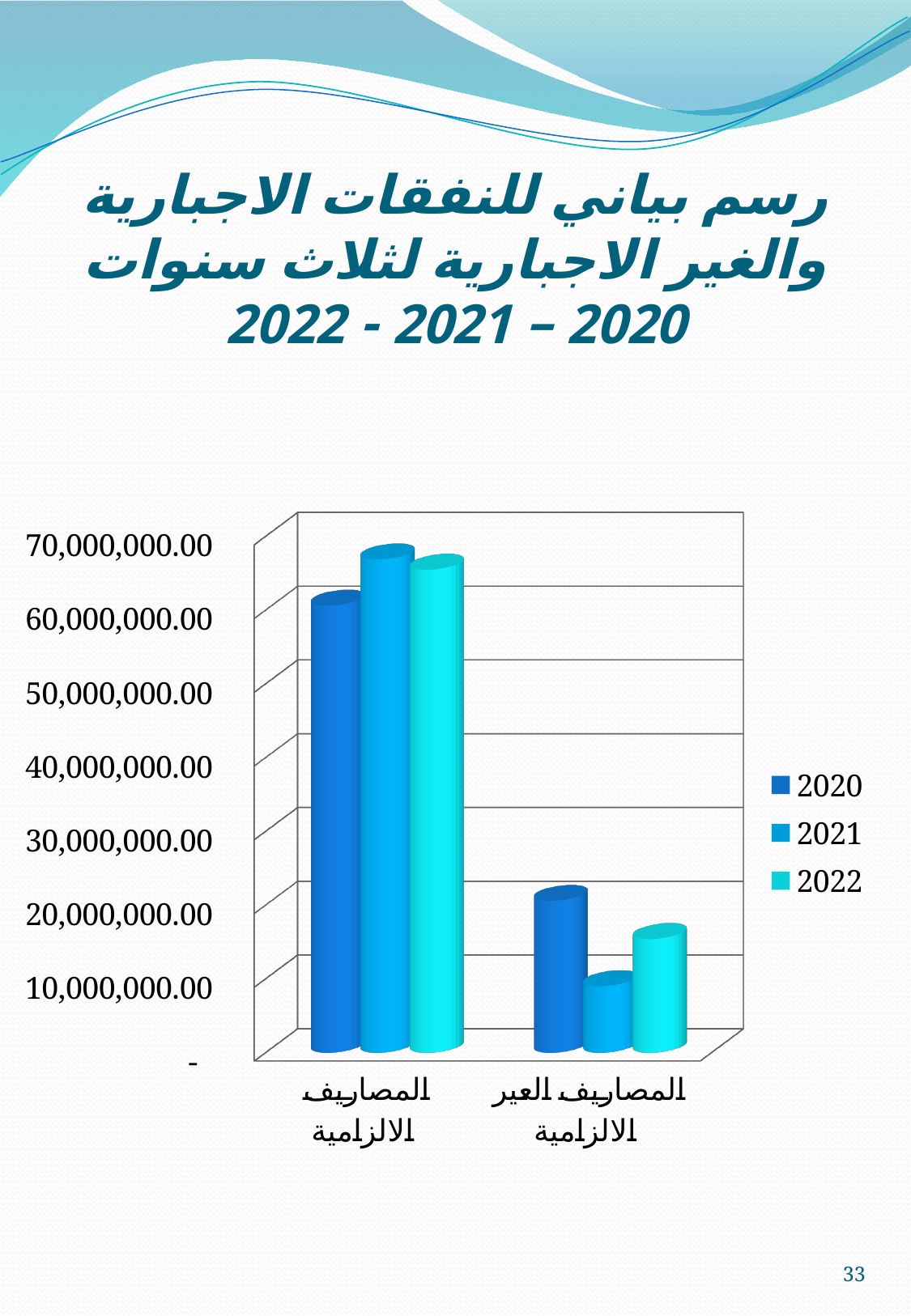
What kind of chart is shown on the slide? bar chart How many series does the legend list? 3 Is the value for 2020 in المصاريف الغير الالزامية greater or less than 10,000,000.00? greater Which year has the lowest value for المصاريف الغير الالزامية? 2021 Is the value for 2022 in المصاريف الغير الالزامية greater or less than 10,000,000.00? greater Is the value for 2020 in المصاريف الالزامية greater or less than 50,000,000.00? greater How many categories are shown on the x axis? 2 For المصاريف الغير الالزامية, which is larger: the value for 2020 or the value for 2021? 2020 Which years are listed in the legend? 2020, 2021, 2022 Which year has the highest value for المصاريف الغير الالزامية? 2020